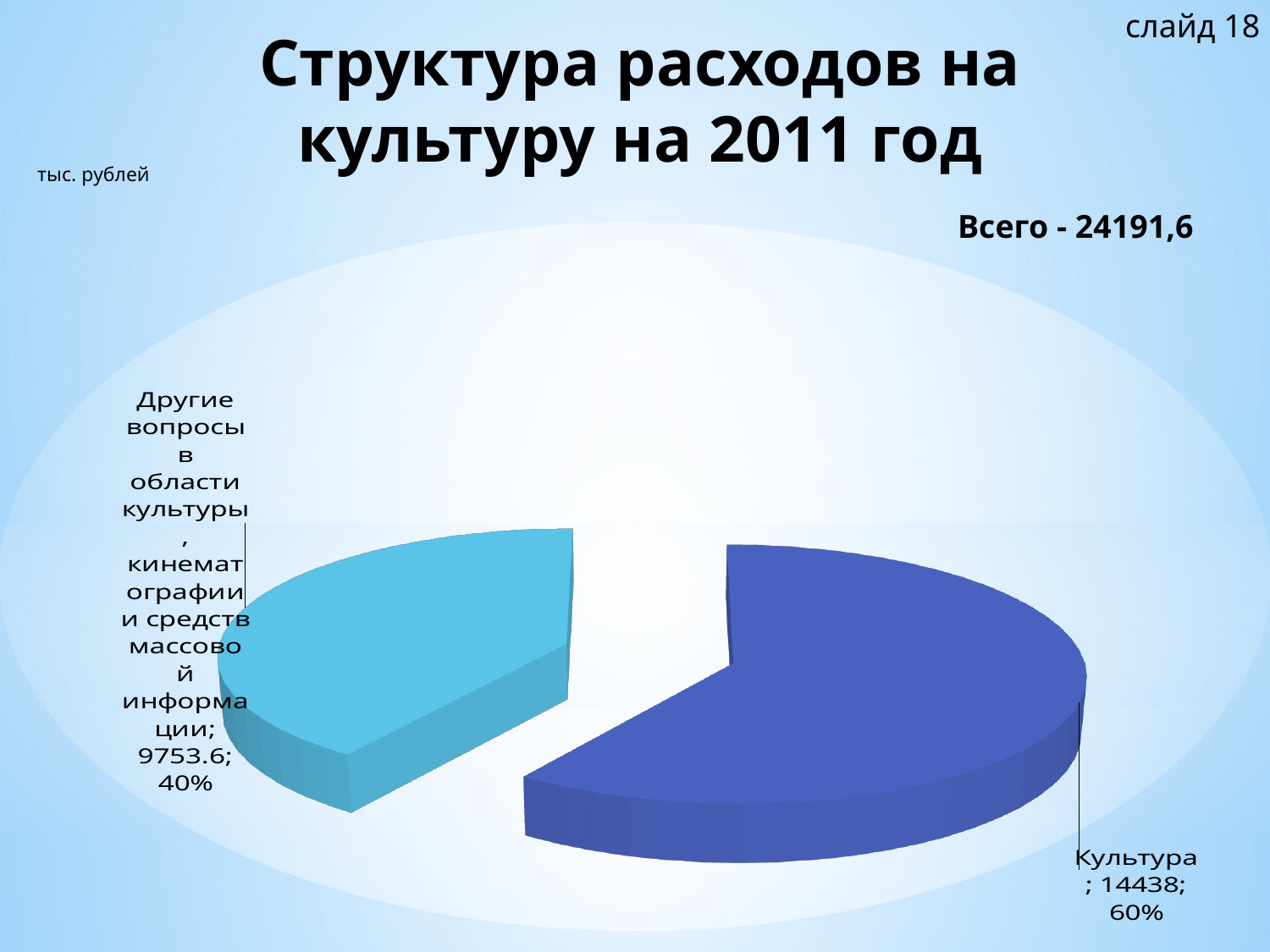
What share of the pie does Культура represent? 60% What share of the pie does Другие вопросы в области культуры, кинематографии и средств массовой информации represent? 40% How many slices does the pie chart have? 2 What is the title of the chart on the slide? Структура расходов на культуру на 2011 год Which slice is the smallest? Другие вопросы в области культуры, кинематографии и средств массовой информации What total (Всего) is stated on the slide? 24191,6 What is the difference between the value for Культура and the value for Другие вопросы в области культуры, кинематографии и средств массовой информации? 4684.4 What is the value for Культура? 14438 What kind of chart is shown on the slide? pie chart Which is larger: Культура or Другие вопросы в области культуры, кинематографии и средств массовой информации? Культура What is the value for Другие вопросы в области культуры, кинематографии и средств массовой информации? 9753.6 Which slice is the largest? Культура